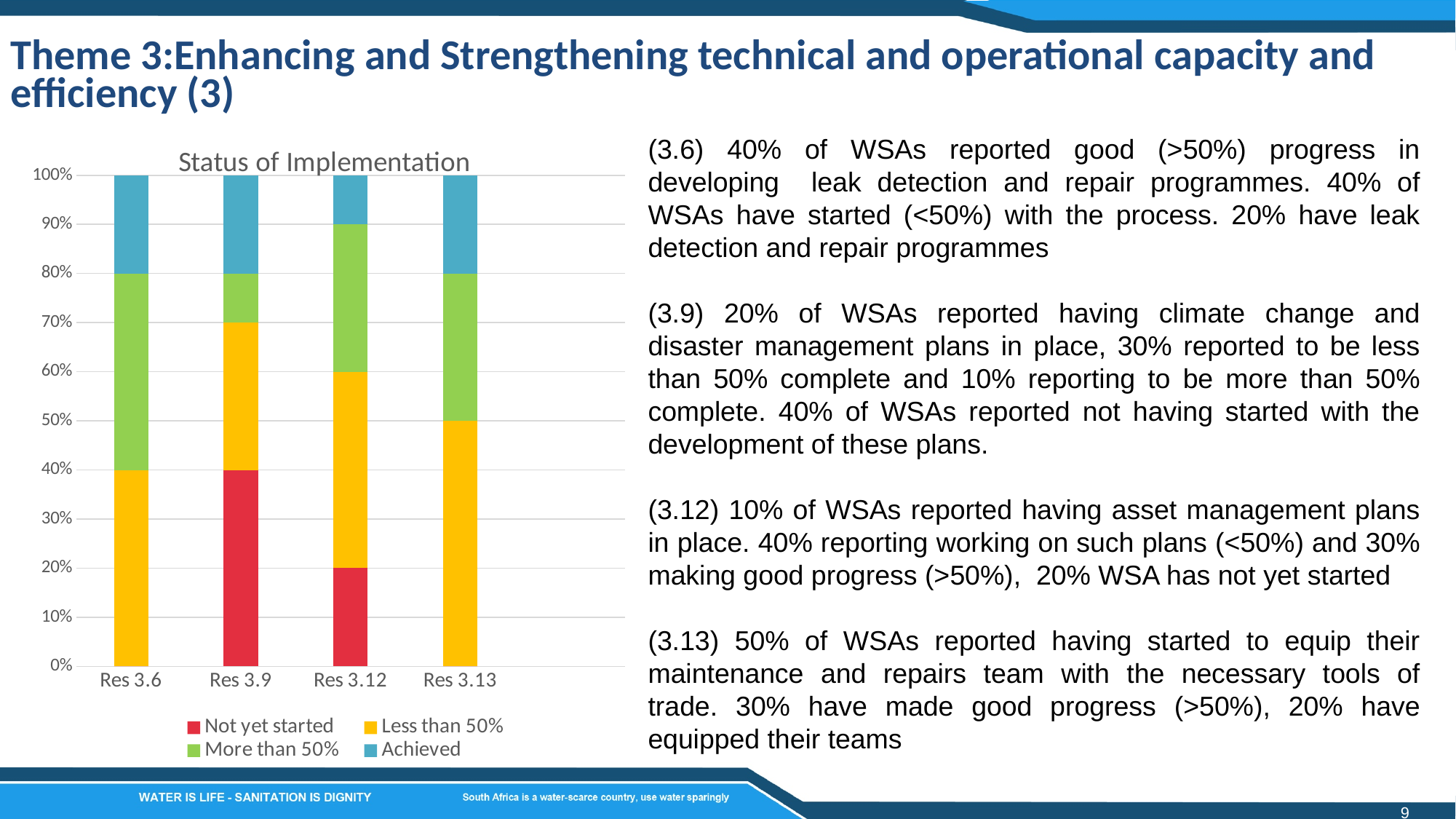
What is the "Not yet started" value for Res 3.9? 40% Which category has the smallest "More than 50%" segment? Res 3.9 What is the title of the chart on the slide? Status of Implementation How many categories are shown on the x axis of the Status of Implementation chart? 4 Which category has the largest "Not yet started" segment? Res 3.9 Is the "Achieved" value for Res 3.12 greater or less than 20%? less Which colour represents the "Not yet started" series in the chart? Red What is the "Less than 50%" value for Res 3.13? 50% Is the "Not yet started" segment larger for Res 3.9 or for Res 3.12? Res 3.9 What is the "Not yet started" value for Res 3.12? 20% What kind of chart is shown under the title "Status of Implementation"? Stacked bar chart How many series does the legend of the Status of Implementation chart list? 4